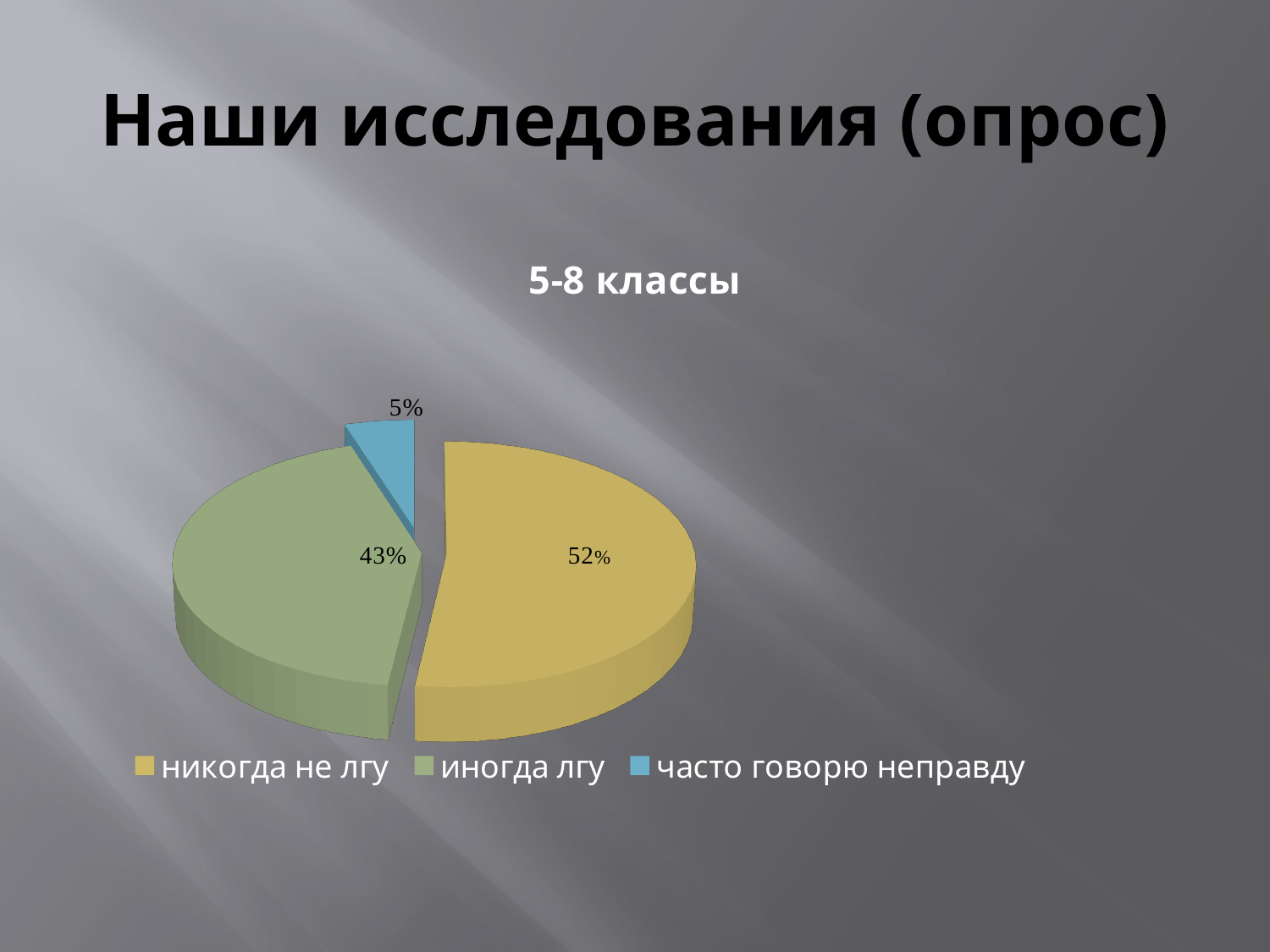
Which category has the largest share of the pie? никогда не лгу How many categories does the pie chart have? 3 Which is larger: the share for "иногда лгу" or the share for "часто говорю неправду"? иногда лгу What percentage of respondents answered "иногда лгу"? 43% What percentage of respondents answered "никогда не лгу"? 52% What type of chart is shown on the slide? pie chart What percentage of respondents answered "часто говорю неправду"? 5% What is the difference in percentage points between "никогда не лгу" and "иногда лгу"? 9 Which category has the smallest share of the pie? часто говорю неправду What colour is the slice for "часто говорю неправду"? blue What is the difference in percentage points between "иногда лгу" and "часто говорю неправду"? 38 What is the title of the chart? 5-8 классы